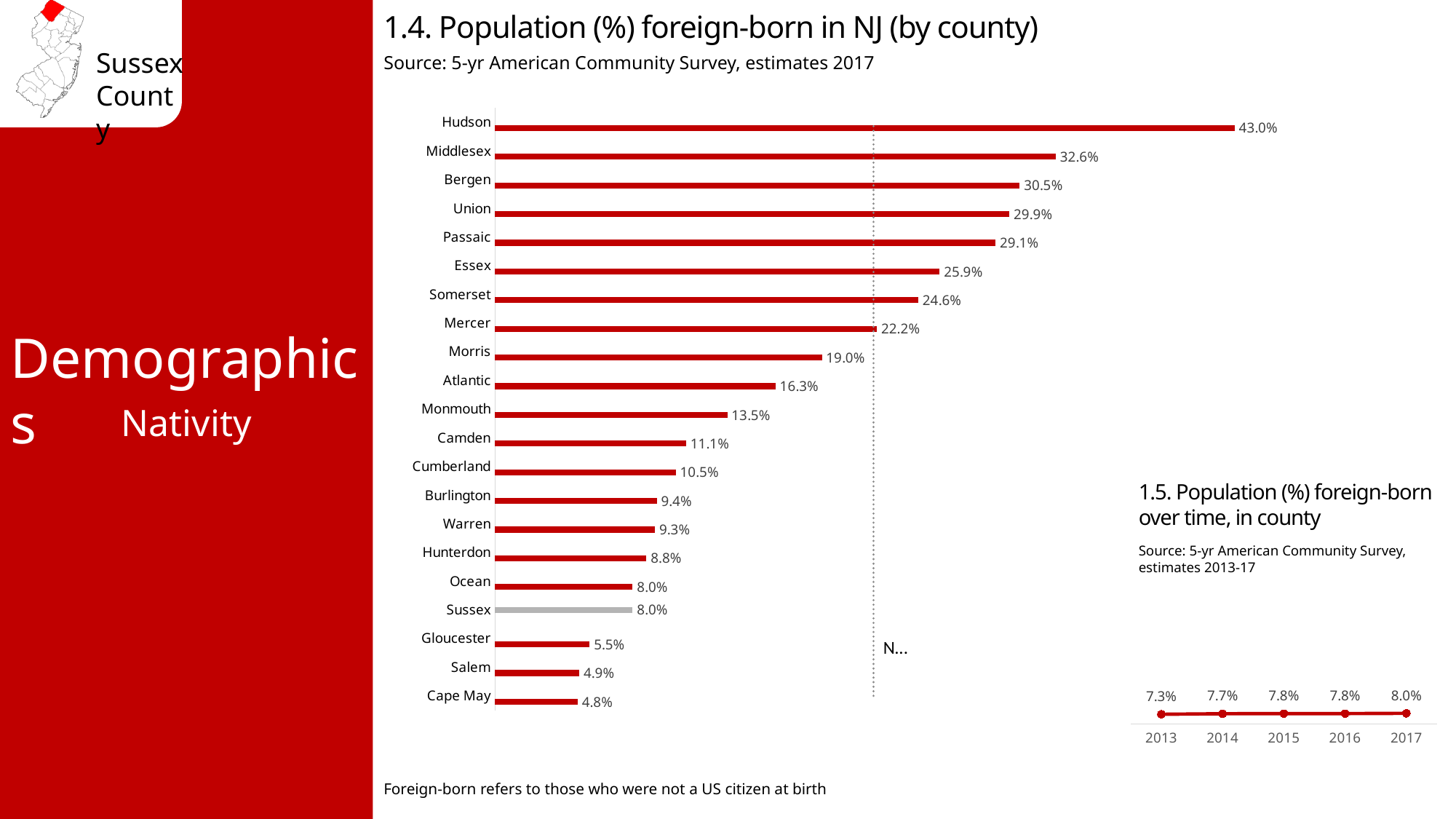
In the chart '1.4. Population (%) foreign-born in NJ (by county)', which is larger, Bergen or Union? Bergen In the chart '1.5. Population (%) foreign-born over time, in county', what is the value for 2013? 7.3% In the chart '1.5. Population (%) foreign-born over time, in county', how many years are plotted? 5 In the chart '1.4. Population (%) foreign-born in NJ (by county)', which county has the lowest value? Cape May What kind of chart is '1.4. Population (%) foreign-born in NJ (by county)'? Bar chart In the chart '1.4. Population (%) foreign-born in NJ (by county)', what is the value for Middlesex? 32.6% In the chart '1.4. Population (%) foreign-born in NJ (by county)', what is the value for Sussex? 8.0% In the chart '1.4. Population (%) foreign-born in NJ (by county)', what is the difference between Hudson and Sussex? 35.0% In the chart '1.4. Population (%) foreign-born in NJ (by county)', which county's bar is shown in grey instead of red? Sussex In the chart '1.4. Population (%) foreign-born in NJ (by county)', how many counties are shown? 21 In the chart '1.5. Population (%) foreign-born over time, in county', do the values rise or fall from 2013 to 2017? Rise In the chart '1.4. Population (%) foreign-born in NJ (by county)', which county has the highest value? Hudson